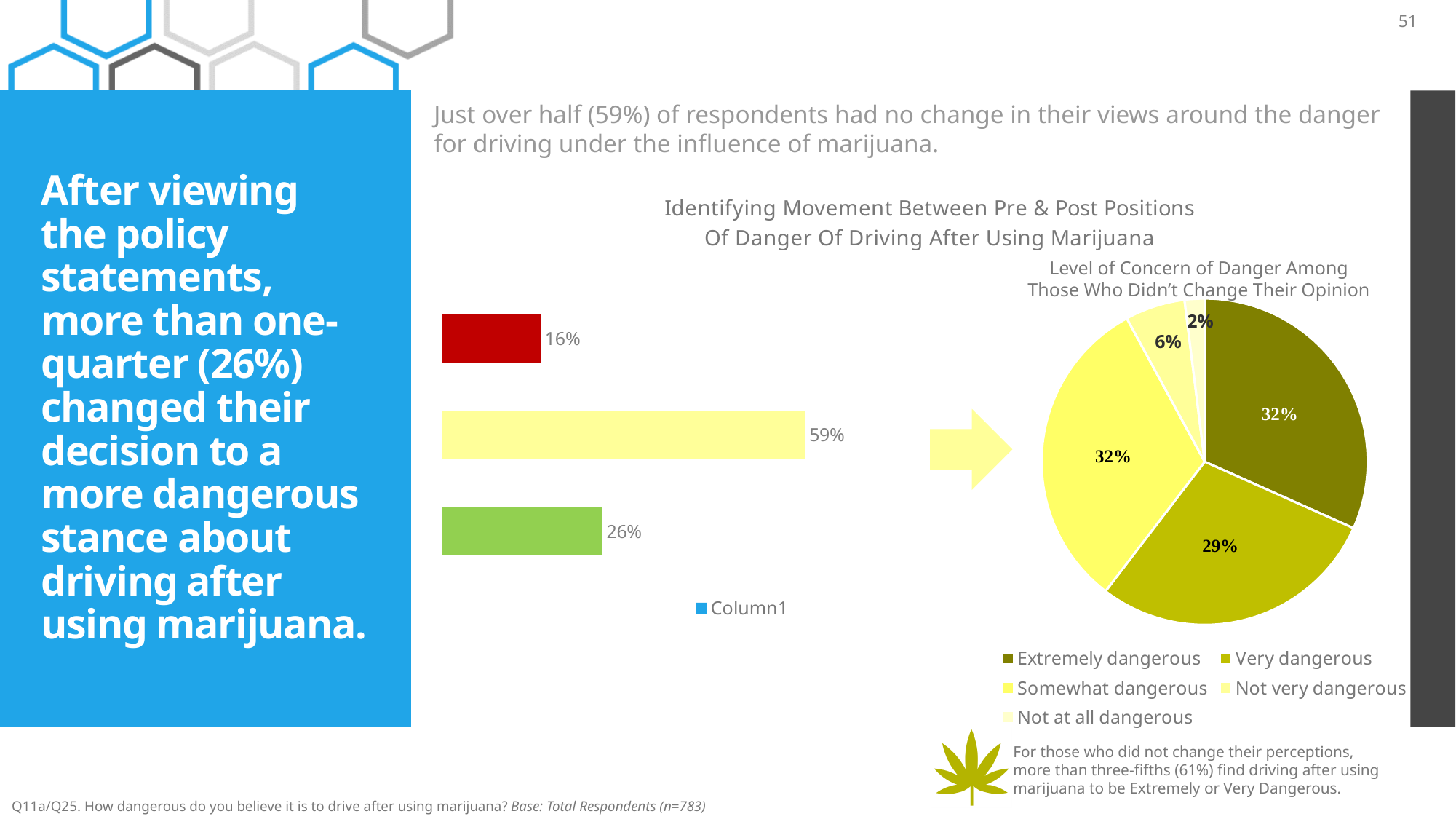
In the 'Level of Concern of Danger' pie chart, what share is 'Very dangerous'? 29% In the 'Identifying Movement Between Pre & Post Positions' bar chart, what value is shown on the green bar? 26% In the 'Level of Concern of Danger' pie chart, what is the combined share of 'Extremely dangerous' and 'Very dangerous'? 61% In the 'Identifying Movement Between Pre & Post Positions' bar chart, what value is shown on the red bar? 16% In the 'Identifying Movement Between Pre & Post Positions' bar chart, what is the value of the longest bar? 59% In the 'Identifying Movement Between Pre & Post Positions' bar chart, what is the difference between the yellow bar and the green bar? 33% What kind of chart is the 'Level of Concern of Danger Among Those Who Didn't Change Their Opinion' chart? pie chart In the 'Level of Concern of Danger' pie chart, what share is 'Not very dangerous'? 6% How many bars are plotted in the 'Identifying Movement Between Pre & Post Positions' bar chart? 3 How many categories does the legend of the 'Level of Concern of Danger' pie chart list? 5 What kind of chart is the 'Identifying Movement Between Pre & Post Positions' chart on the left? bar chart In the 'Level of Concern of Danger' pie chart, which category has the smallest slice? Not at all dangerous